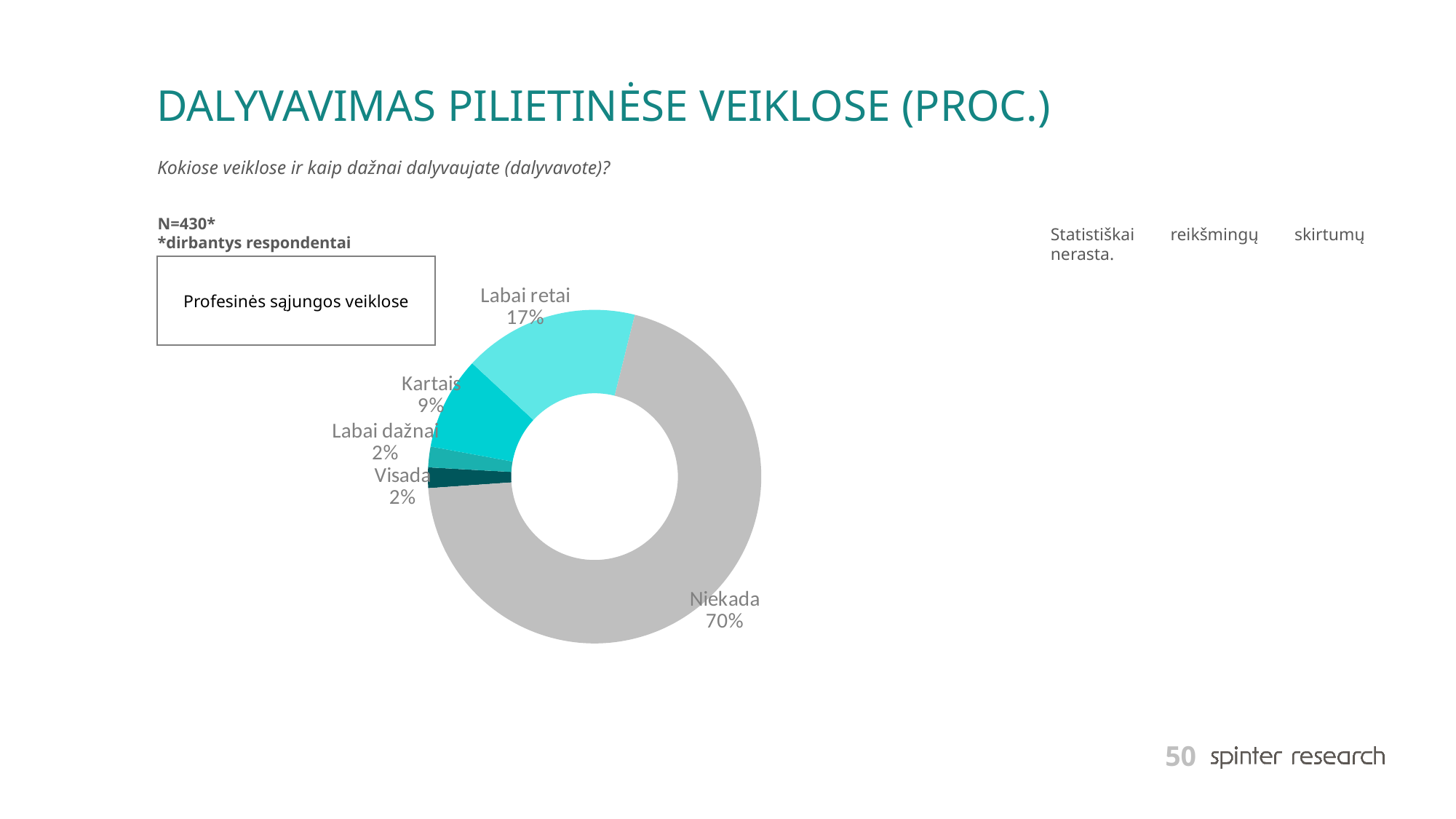
Which is larger, the share for "Kartais" or the share for "Labai dažnai"? Kartais What share of respondents answered "Visada"? 2% What share of respondents answered "Kartais"? 9% Which activity does the chart refer to, according to the box next to it? Profesinės sąjungos veiklose What is the sample size (N) stated on the slide? N=430* What share of respondents answered "Niekada"? 70% What share of respondents answered "Labai retai"? 17% How many categories are shown in the chart? 5 What is the difference in percentage points between "Labai retai" and "Kartais"? 8 Which category has the largest share of the chart? Niekada What kind of chart is shown on the slide? Donut (pie) chart What is the difference in percentage points between "Niekada" and "Labai retai"? 53